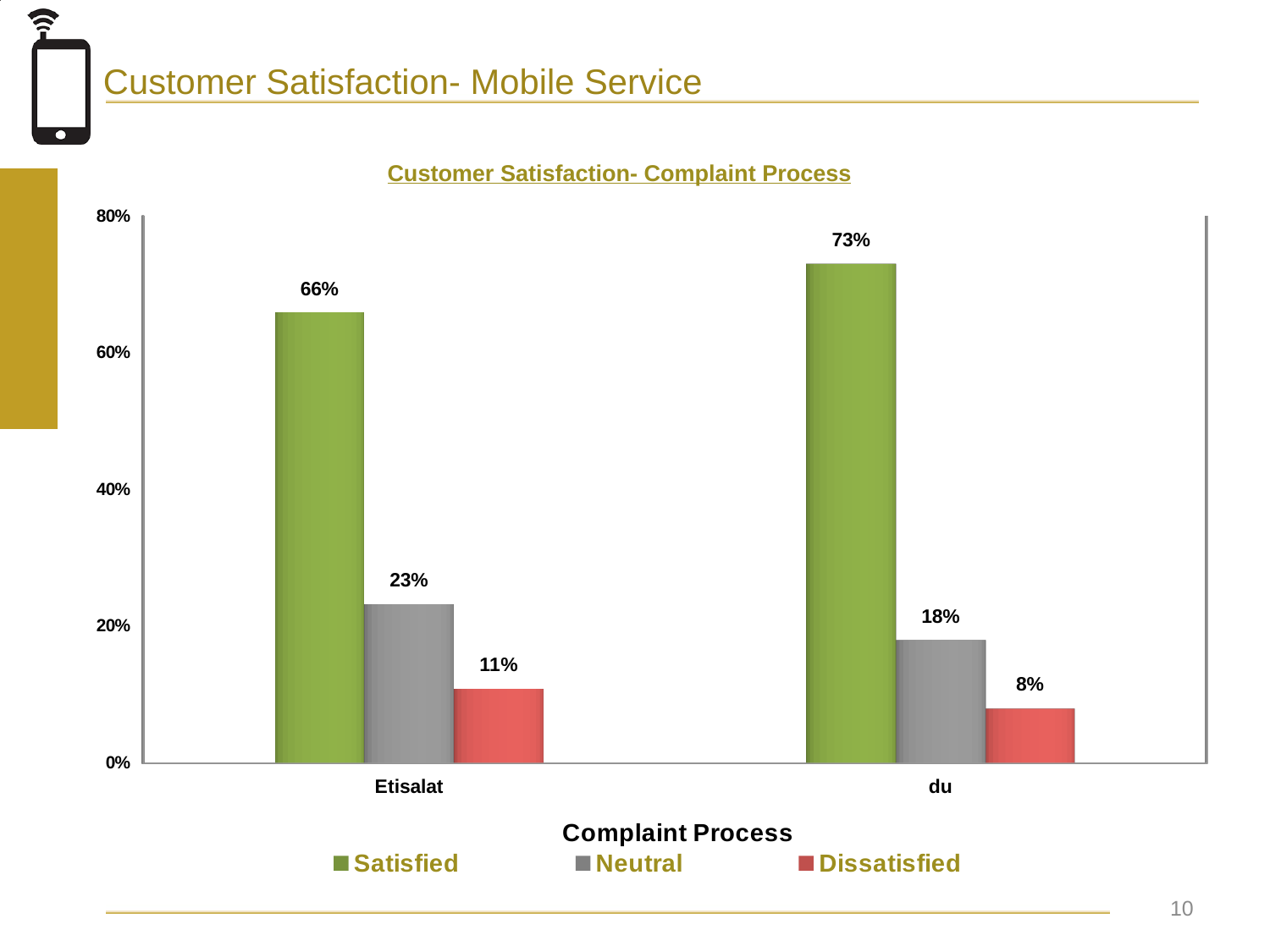
What percentage of Etisalat customers are Satisfied with the complaint process? 66% What kind of chart is shown on the slide? Bar chart What is the difference between the Neutral values for Etisalat and du? 5% How many providers (categories) are shown on the x axis? 2 What is the difference between the Satisfied values for du and Etisalat? 7% What is the Dissatisfied value for du? 8% Which colour represents the Dissatisfied series in the legend? Red What is the Neutral value for Etisalat? 23% What is the title of the chart? Customer Satisfaction- Complaint Process Which provider has the lower Dissatisfied percentage? du Which provider has the higher Satisfied percentage? du How many series does the legend list? 3